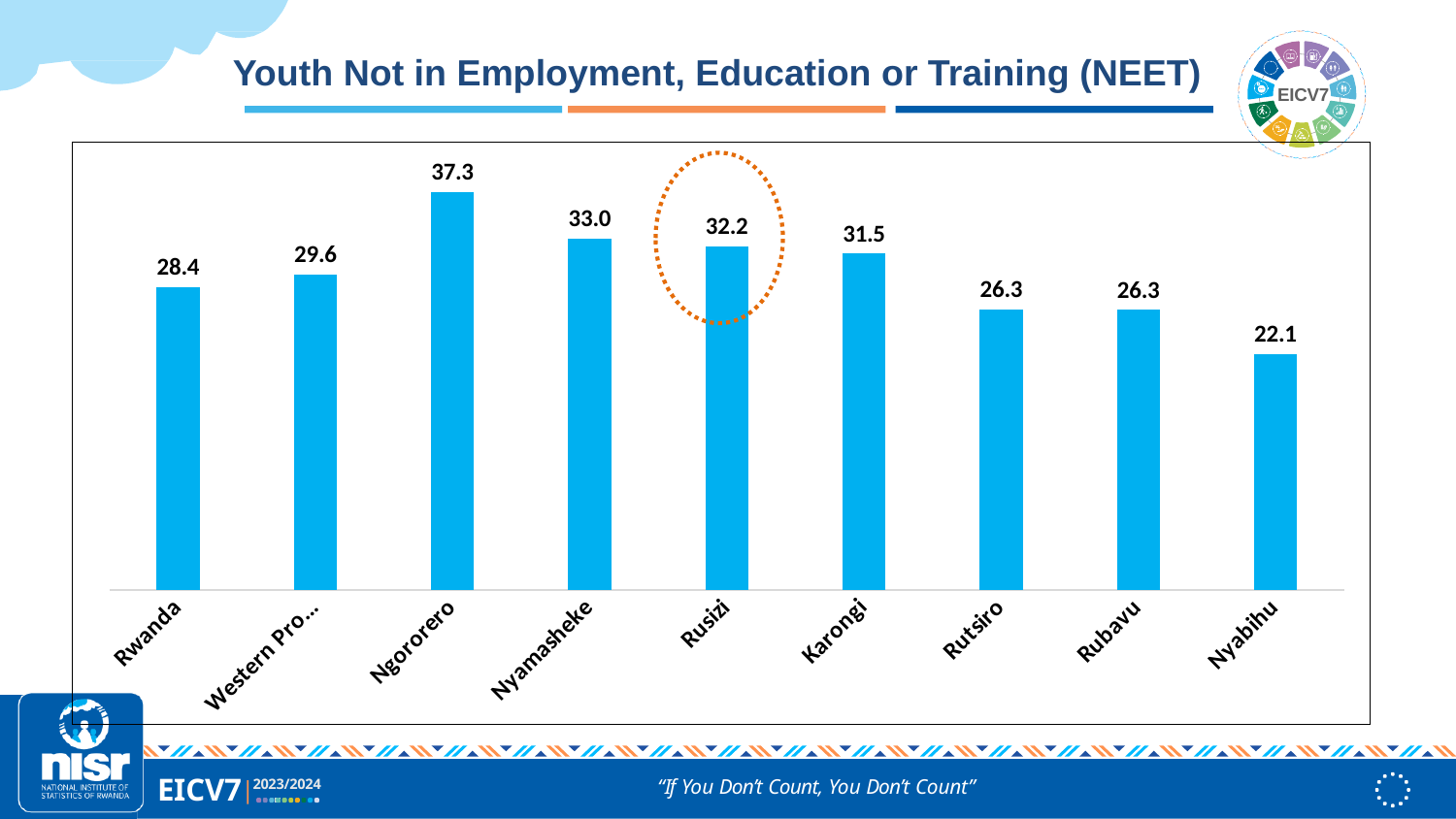
What is the NEET value for Ngororero? 37.3 What is the NEET value for Rwanda? 28.4 What is the NEET value for Nyabihu? 22.1 Which category has the highest NEET value? Ngororero Which has a higher NEET value, Rusizi or Rwanda? Rusizi How many categories are shown on the chart? 9 Which category has the lowest NEET value? Nyabihu What is the NEET value for Rusizi? 32.2 What is the difference between the NEET values for Nyamasheke and Karongi? 1.5 What is the difference between the NEET values for Ngororero and Nyabihu? 15.2 Which bar on the chart is highlighted with a dotted circle? Rusizi What kind of chart is shown on the slide? Bar chart